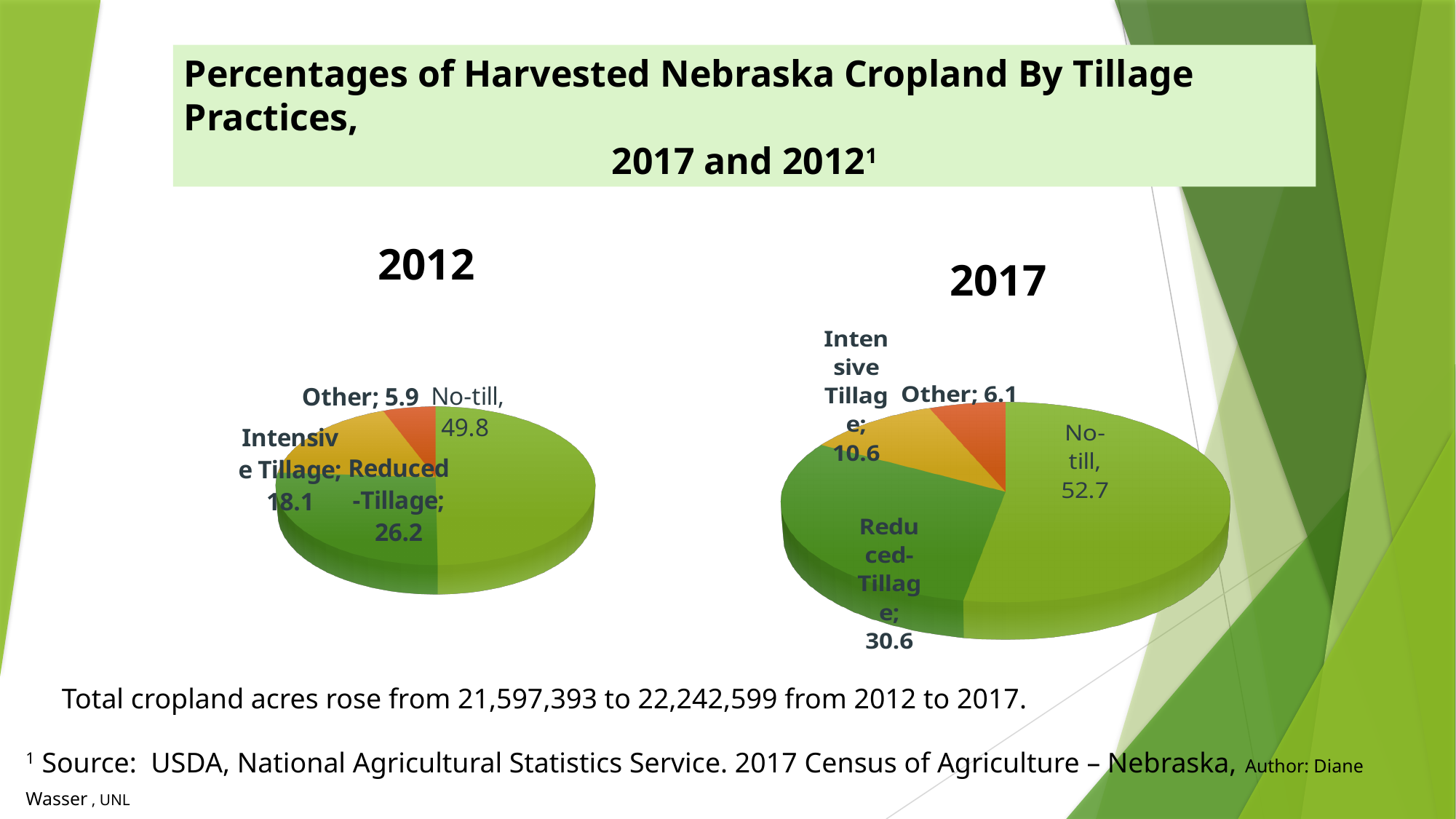
In the 2012 pie chart, what is the value for No-till? 49.8 In the 2012 pie chart, what is the difference between Reduced-Tillage and Intensive Tillage? 8.1 In the 2017 pie chart, which category has the largest slice? No-till How many slices does the 2017 pie chart have? 4 What is the difference between the No-till value in 2017 and the No-till value in 2012? 2.9 In the 2017 pie chart, what is the value for Other? 6.1 How many pie charts are shown on the slide? 2 In the 2012 pie chart, what is the value for Intensive Tillage? 18.1 What kind of chart is used to show the 2012 data? Pie chart In the 2017 pie chart, what is the value for Reduced-Tillage? 30.6 Which is larger: Intensive Tillage in 2012 or Intensive Tillage in 2017? Intensive Tillage in 2012 In the 2012 pie chart, which category has the smallest slice? Other